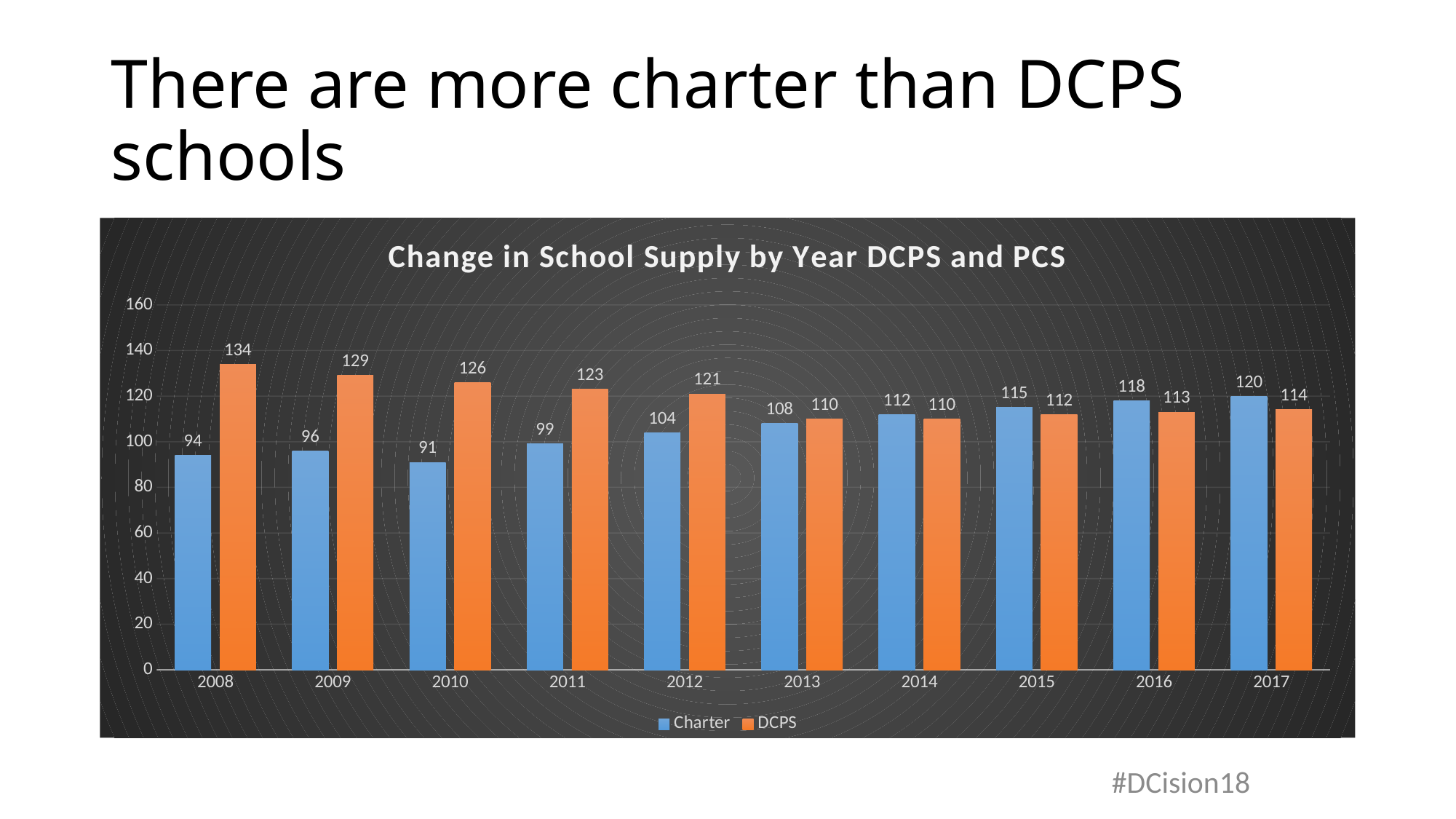
Which is larger in 2014, the Charter value or the DCPS value? Charter What is the difference between the DCPS and Charter values in 2008? 40 How many series does the legend list? 2 What is the DCPS value for 2017? 114 What kind of chart is shown? bar chart Which year has the highest DCPS value? 2008 What is the Charter value for 2012? 104 Which year has the lowest Charter value? 2010 Do the DCPS values rise or fall from 2008 to 2013? fall How many years are shown on the x axis? 10 Is the DCPS value for 2009 greater or less than 120? greater What is the Charter value for 2008? 94